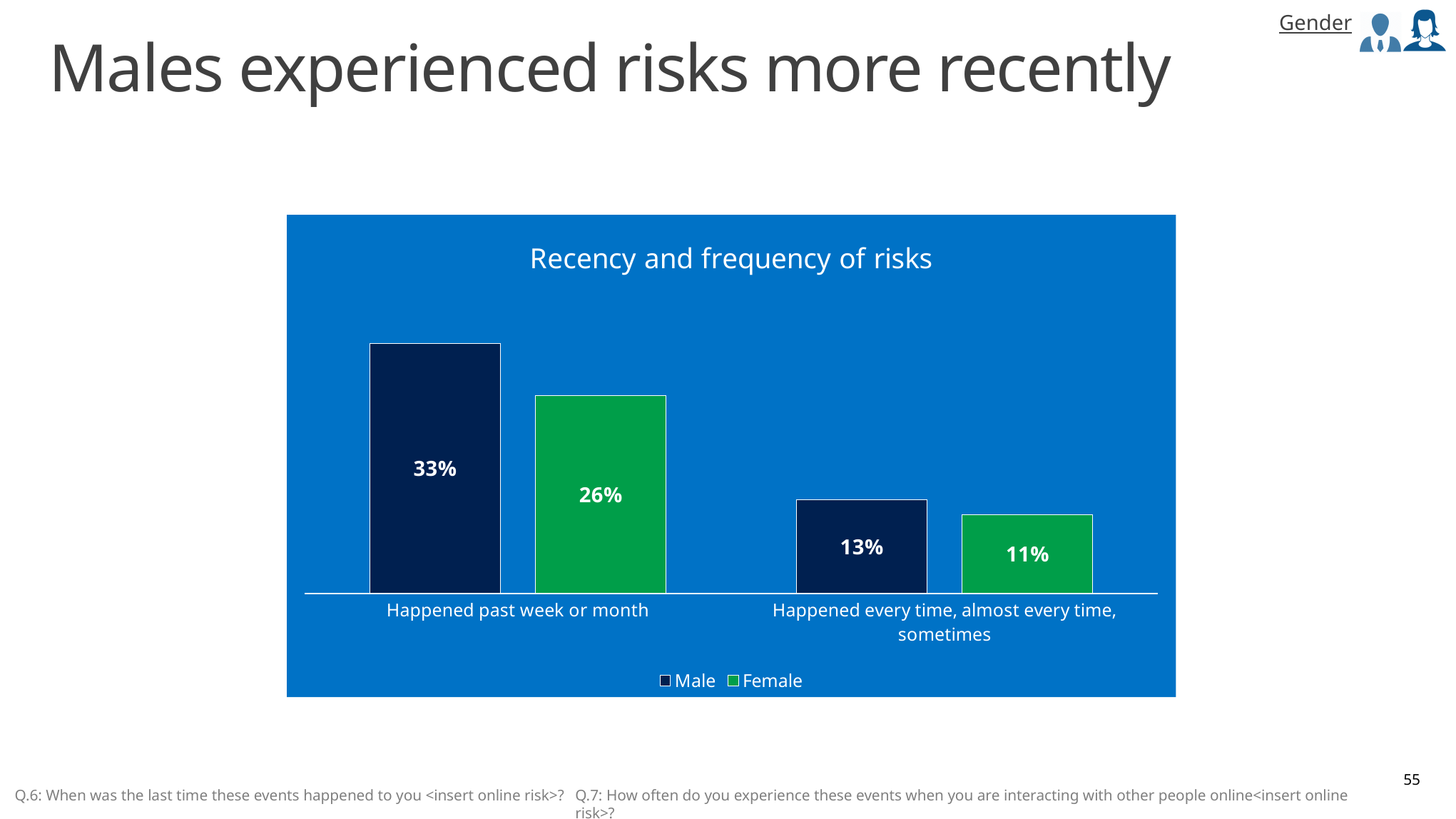
What is the value for Female in the 'Happened every time, almost every time, sometimes' category? 11% What is the value for Female in the 'Happened past week or month' category? 26% How many series does the legend list? 2 What is the value for Male in the 'Happened every time, almost every time, sometimes' category? 13% How many categories are shown on the x axis? 2 Which bar has the lowest value on the chart? Female, Happened every time, almost every time, sometimes What type of chart is shown on the slide? Bar chart Which series has the highest value in the 'Happened past week or month' category? Male What is the difference between the Male and Female values for 'Happened past week or month'? 7% What is the value for Male in the 'Happened past week or month' category? 33% What is the difference between the Male and Female values for 'Happened every time, almost every time, sometimes'? 2% Which is larger: the Female value for 'Happened past week or month' or the Male value for 'Happened every time, almost every time, sometimes'? Female value for 'Happened past week or month'